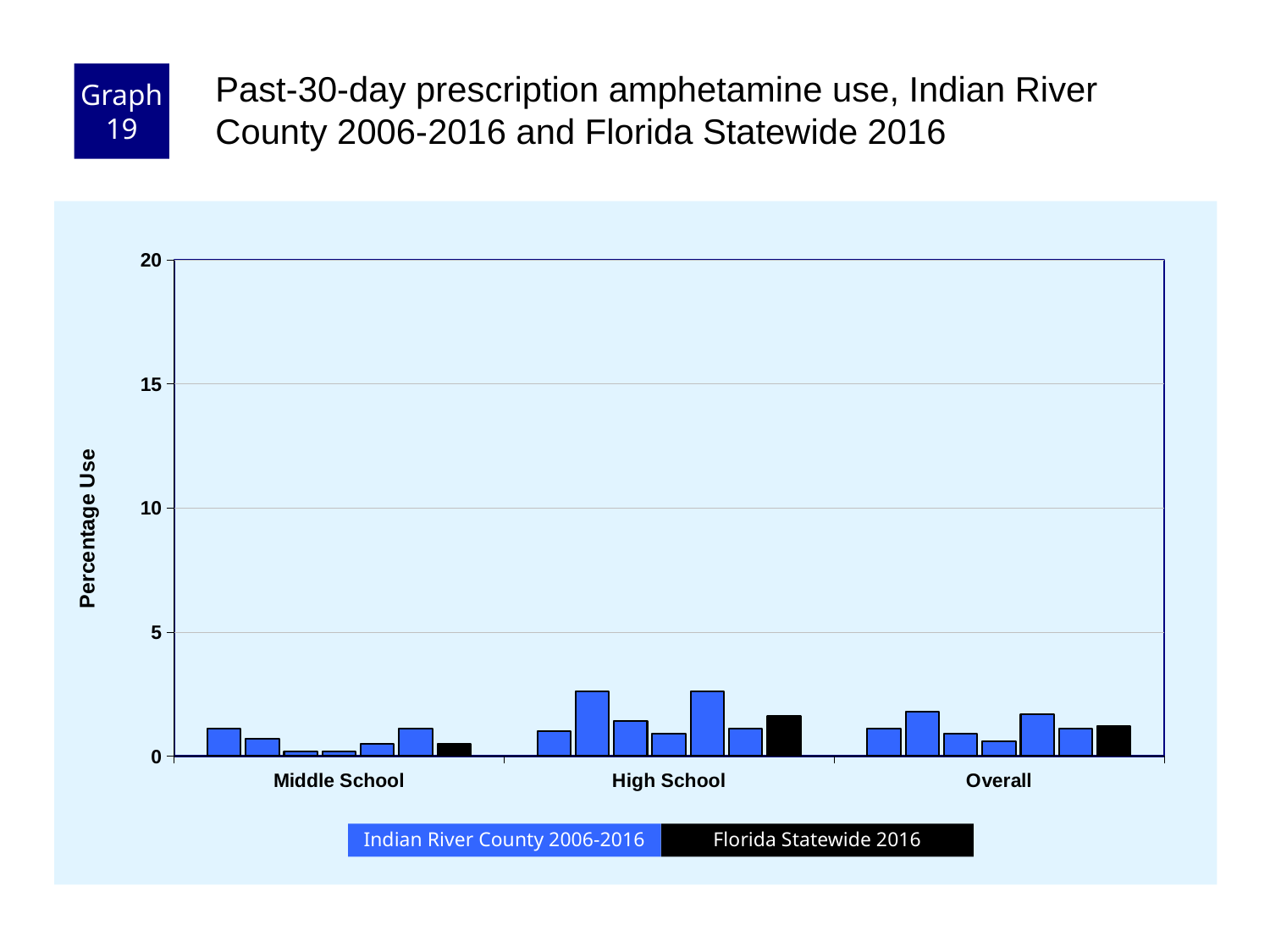
Is the Florida Statewide 2016 value for Middle School greater or less than 5? less Which series is shown in black in the legend? Florida Statewide 2016 How many category groups are shown on the x axis? 3 Is the Florida Statewide 2016 value for High School greater or less than 5? less Are any of the bars on the chart greater than 10? No How many series does the legend list? 2 Which is larger, the Florida Statewide 2016 value for High School or for Middle School? High School Among the three groups, which has the lowest Florida Statewide 2016 value? Middle School What is the label of the y axis? Percentage Use What kind of chart is shown on the slide? bar chart Among the three groups, which has the highest Florida Statewide 2016 value? High School